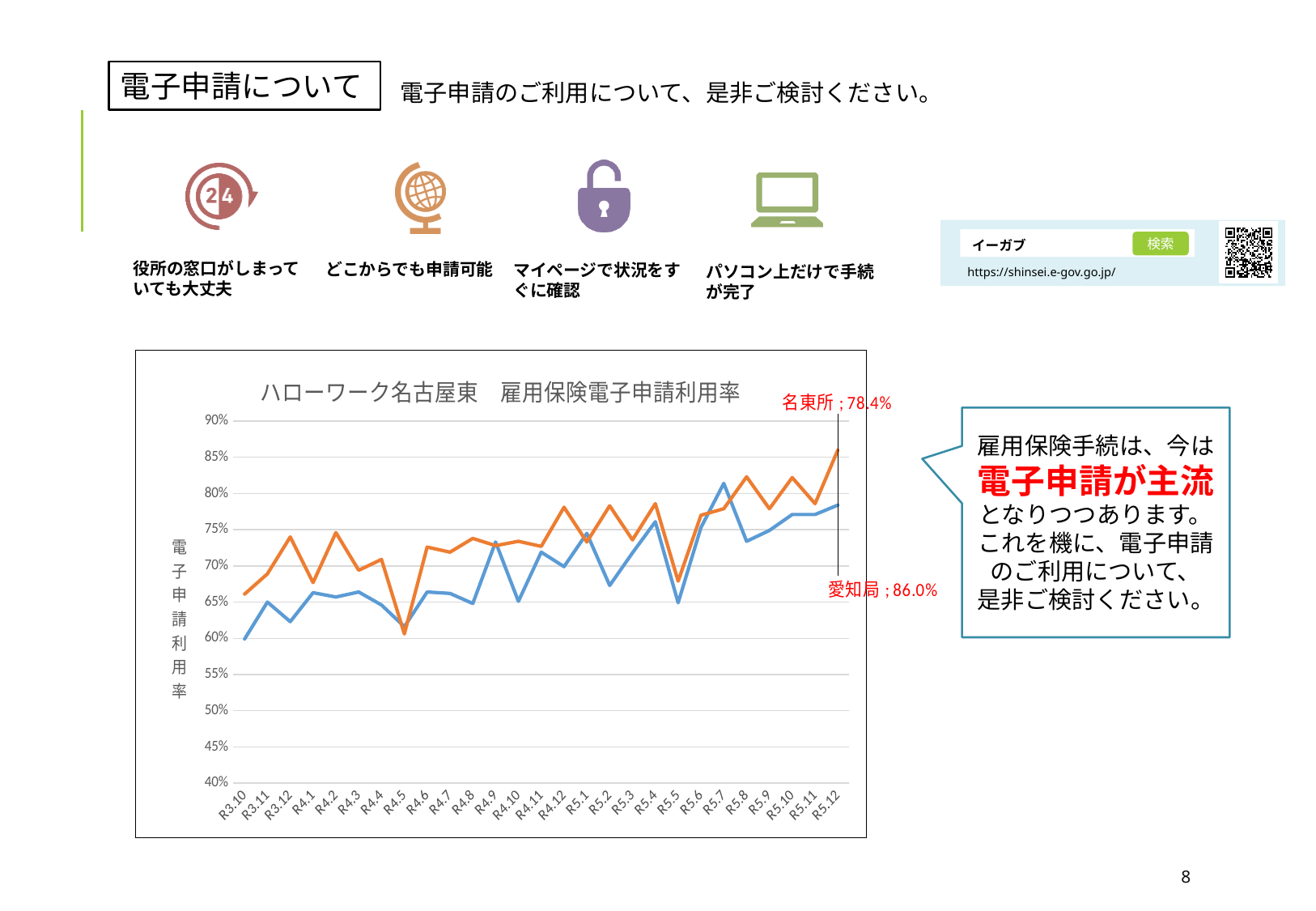
Is the value for 名東所 at R3.10 greater or less than 65%? less Is the value for 愛知局 at R5.8 greater or less than 80%? greater How many time points are plotted along the x axis, from R3.10 to R5.12? 27 What is the value labelled for 名東所 at the end of the chart (R5.12)? 78.4% Is the value for 愛知局 at R4.5 greater or less than 65%? less Overall, do the electronic application usage rates rise or fall from R3.10 to R5.12? rise What is the label on the vertical axis of the chart? 電子申請利用率 At R5.12, which is higher, 名東所 or 愛知局? 愛知局 What kind of chart is shown on the slide? line chart What is the difference between the 愛知局 value (86.0%) and the 名東所 value (78.4%) at R5.12? 7.6 percentage points What is the value labelled for 愛知局 at the end of the chart (R5.12)? 86.0% What is the title of the chart? ハローワーク名古屋東 雇用保険電子申請利用率